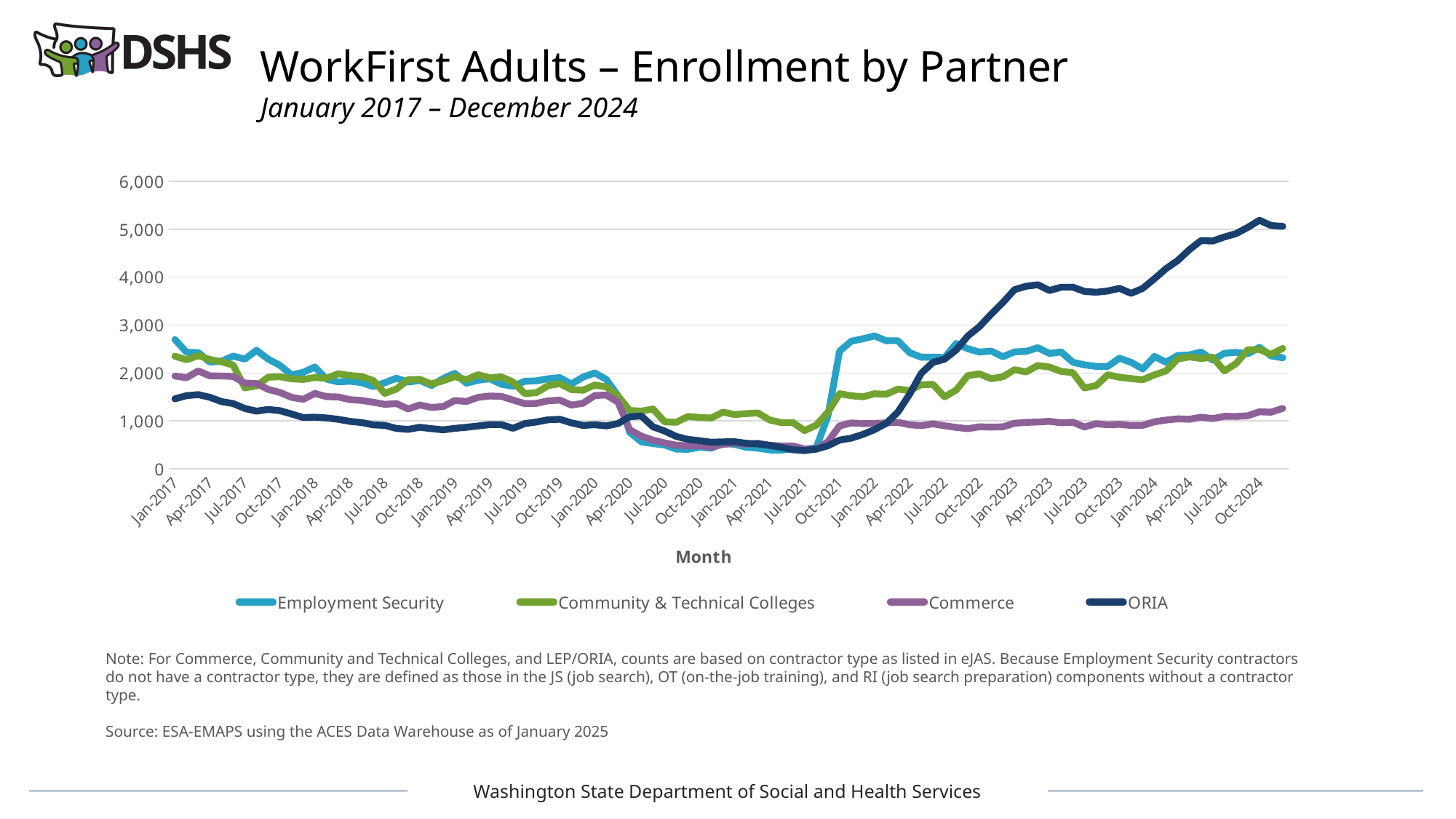
In Jan-2017, which is larger: Employment Security or ORIA? Employment Security Which series is plotted with the dark navy line? ORIA In Oct-2024, which is larger: ORIA or Commerce? ORIA Is the value for Employment Security in Jan-2017 greater or less than 2,000? greater Is the value for Commerce in Jan-2024 greater or less than 2,000? less What is the title of the x axis? Month How many series does the legend list? 4 What kind of chart is shown on the slide? line chart Is the value for ORIA in Jan-2017 greater or less than 2,000? less Does the ORIA line rise or fall between Jan-2022 and Oct-2024? rise Which series has the highest value in Oct-2024? ORIA